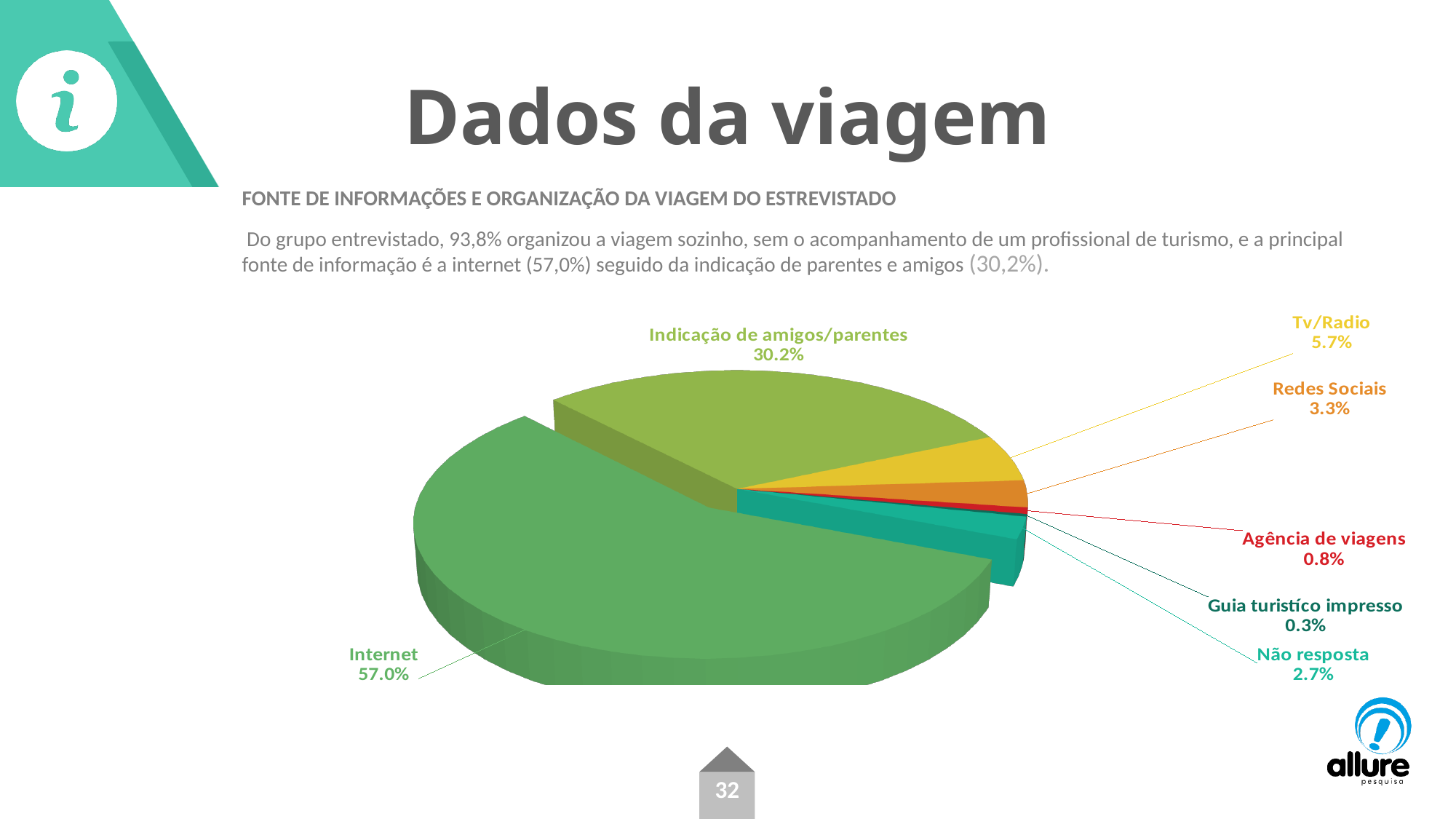
How many categories are shown in the pie chart? 7 What percentage is shown for Tv/Radio? 5.7% What is the value for Agência de viagens? 0.8% Which is larger, Redes Sociais or Não resposta? Redes Sociais Which category has the largest slice of the pie? Internet What colour is the Internet slice of the pie? Green What is the difference between the Internet share and the Indicação de amigos/parentes share? 26.8% What is the combined share of Tv/Radio and Redes Sociais? 9.0% What share of the pie does Internet account for? 57.0% Which category has the smallest slice of the pie? Guia turistíco impresso What is the value shown for Indicação de amigos/parentes? 30.2% What kind of chart is shown on the slide? Pie chart